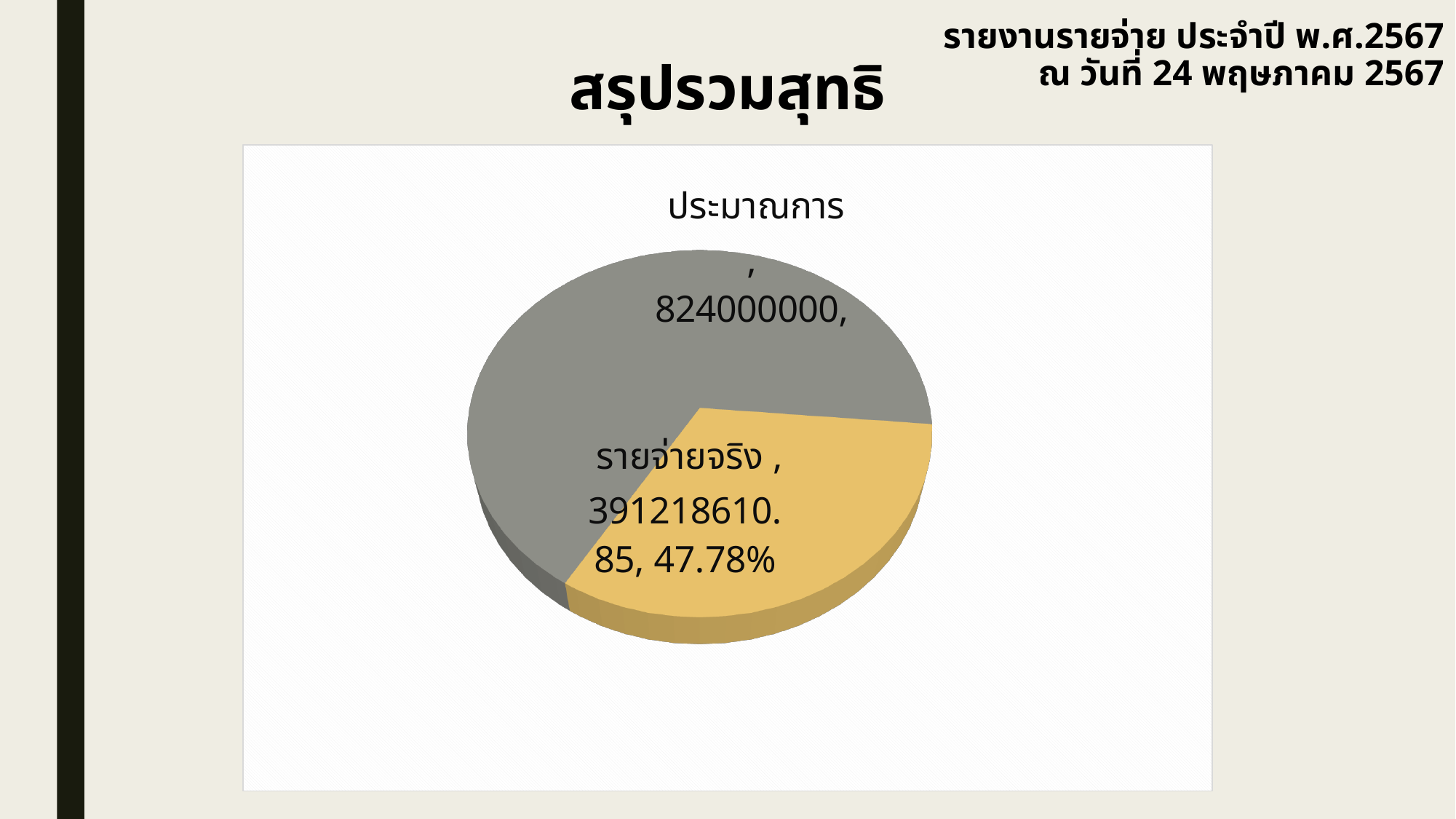
What is the value shown for รายจ่ายจริง in the pie chart? 391218610.85 What percentage share of the pie does รายจ่ายจริง have? 47.78% What colour is the ประมาณการ slice in the pie chart? gray Which is larger, the value for ประมาณการ or the value for รายจ่ายจริง? ประมาณการ What is the difference between the value for ประมาณการ and the value for รายจ่ายจริง? 432781389.15 What colour is the รายจ่ายจริง slice in the pie chart? yellow What is the value shown for ประมาณการ in the pie chart? 824000000 What kind of chart is shown on the slide? pie chart Which slice of the pie chart is the smallest? รายจ่ายจริง Which slice of the pie chart is the largest? ประมาณการ How many slices does the pie chart have? 2